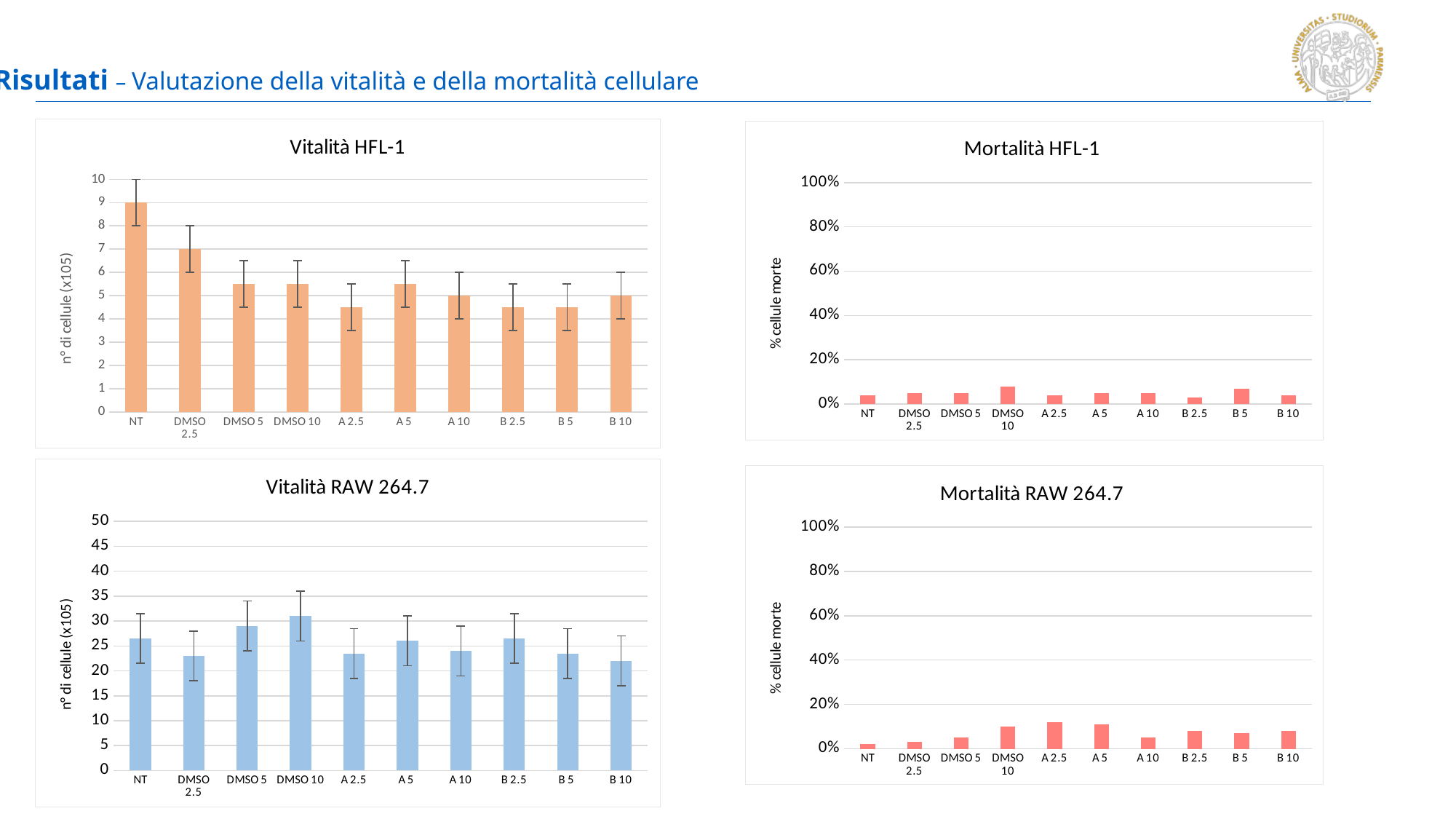
In the Vitalità RAW 264.7 chart, is the value for DMSO 10 greater or less than 30? greater How many categories are shown on the x axis of the Mortalità HFL-1 chart? 10 In the Vitalità HFL-1 chart, which category has the highest value? NT In the Vitalità HFL-1 chart, what is the difference between the values for NT and DMSO 2.5? 2 In the Vitalità HFL-1 chart, what is the value for DMSO 2.5? 7 In the Vitalità HFL-1 chart, which is larger, the value for NT or the value for B 10? NT In the Vitalità RAW 264.7 chart, is the value for B 10 greater or less than 25? less In the Vitalità HFL-1 chart, what is the value for NT? 9 What kind of chart is the Vitalità RAW 264.7 chart? bar chart In the Vitalità HFL-1 chart, what is the value for A 10? 5 In the Vitalità RAW 264.7 chart, which category has the highest value? DMSO 10 In the Mortalità RAW 264.7 chart, is the value for A 2.5 greater or less than 20%? less